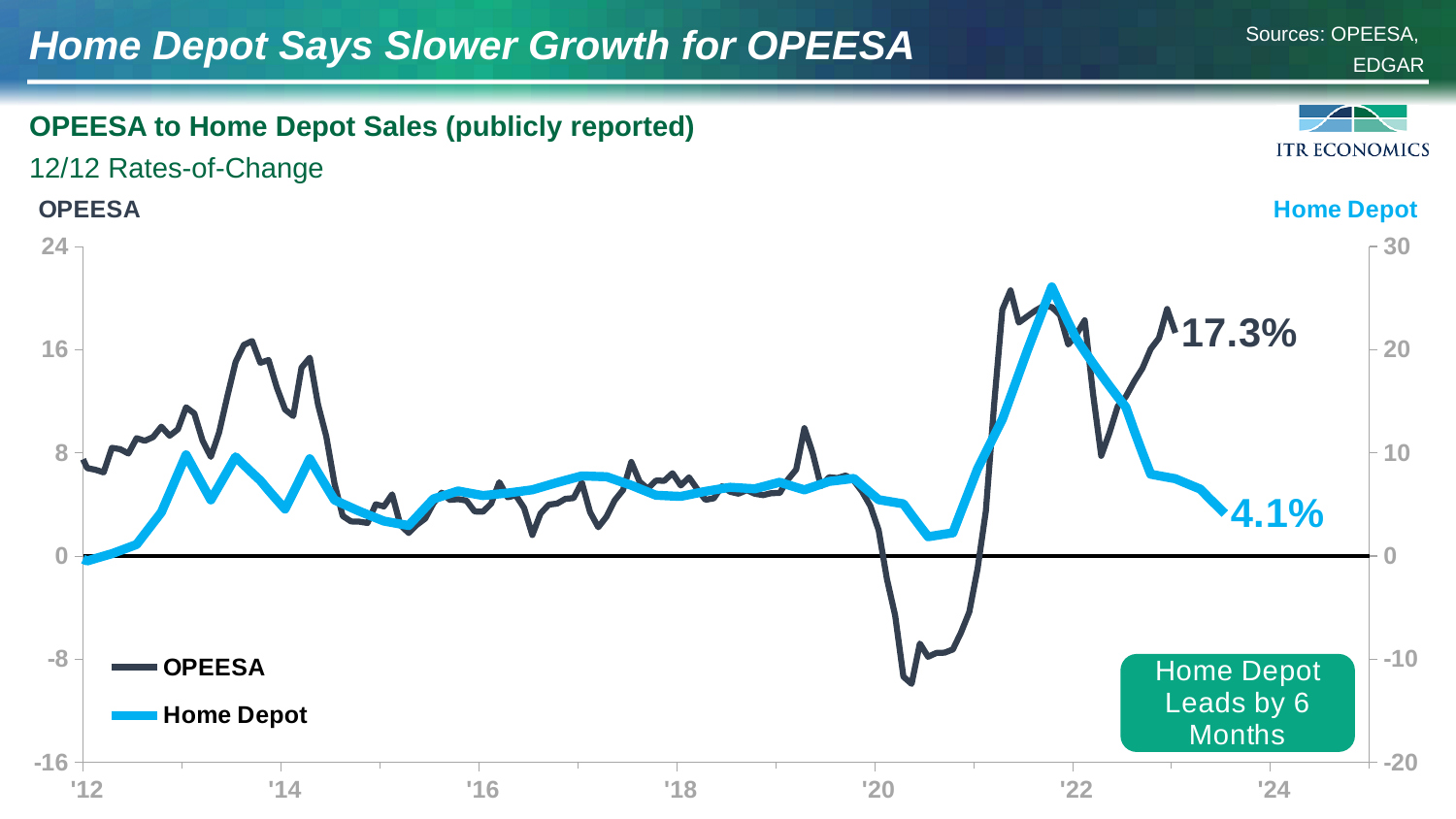
What is the latest labelled value for the OPEESA series? 17.3% What is the title of the chart? OPEESA to Home Depot Sales (publicly reported) Is the lowest point of the OPEESA line around 2020 greater or less than -8 on the left axis? less What is the latest labelled value for the Home Depot series? 4.1% Does the Home Depot line rise or fall from its 2022 peak to the end of the series? Fall What kind of chart is shown on the slide? Line chart What does the green callout box on the chart say? Home Depot Leads by 6 Months Is the peak of the Home Depot line around 2022 greater or less than 20 on the right axis? greater Which series has the higher latest labelled value, OPEESA or Home Depot? OPEESA How many year labels are shown on the x axis? 7 How many series does the legend list? 2 What is the difference between the latest labelled OPEESA value (17.3%) and the latest labelled Home Depot value (4.1%)? 13.2 percentage points